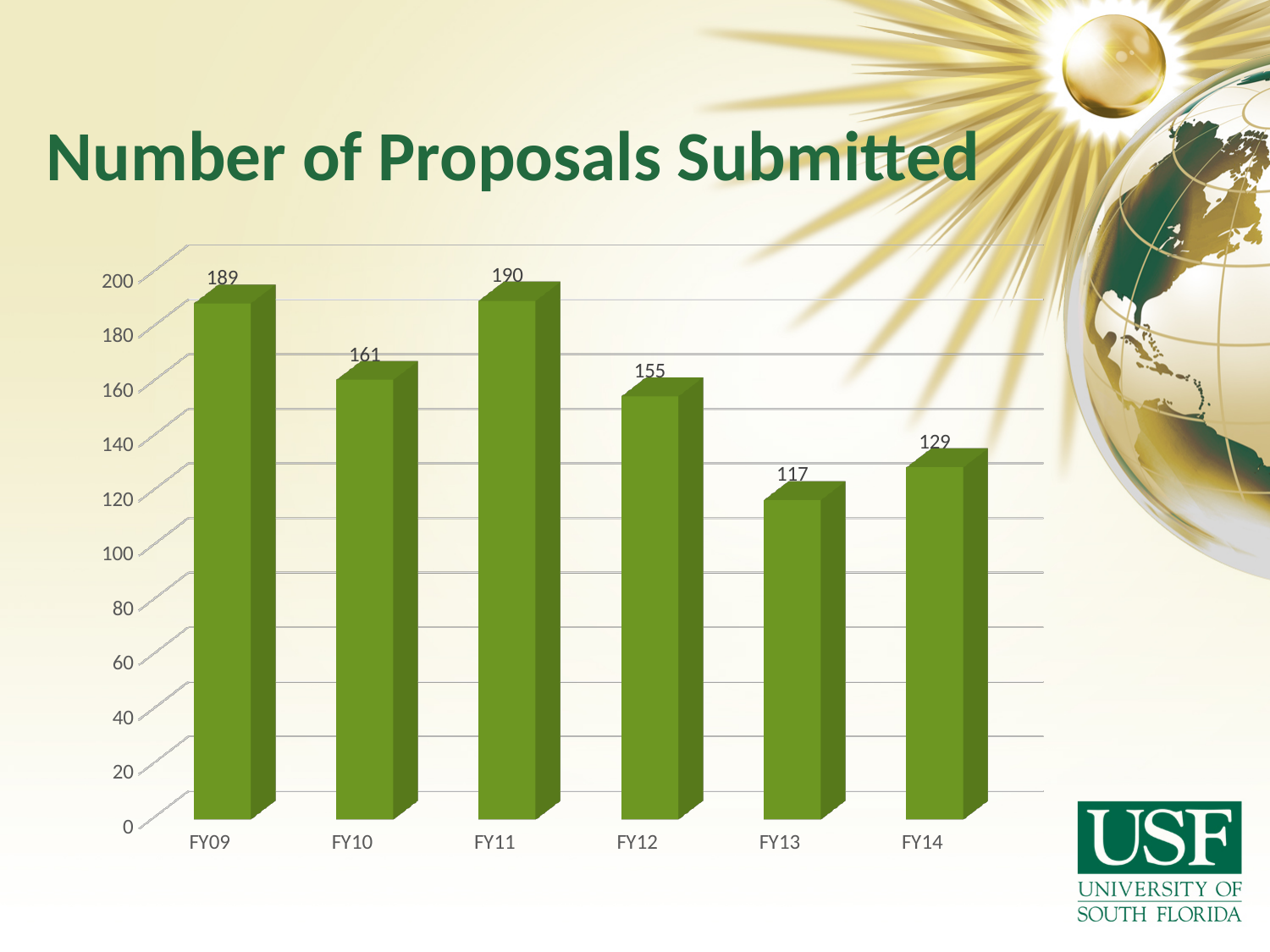
What is the number of proposals submitted in FY12? 155 How many fiscal years are shown on the chart? 6 Is the value for FY13 greater or less than 120? less What is the difference between the number of proposals submitted in FY11 and FY13? 73 What is the number of proposals submitted in FY09? 189 What is the number of proposals submitted in FY14? 129 Which fiscal year has the lowest number of proposals submitted? FY13 Which fiscal year has the highest number of proposals submitted? FY11 Which fiscal year had more proposals submitted, FY10 or FY14? FY10 What is the title of the chart? Number of Proposals Submitted What is the difference between the number of proposals submitted in FY10 and FY12? 6 What kind of chart is shown on the slide? bar chart